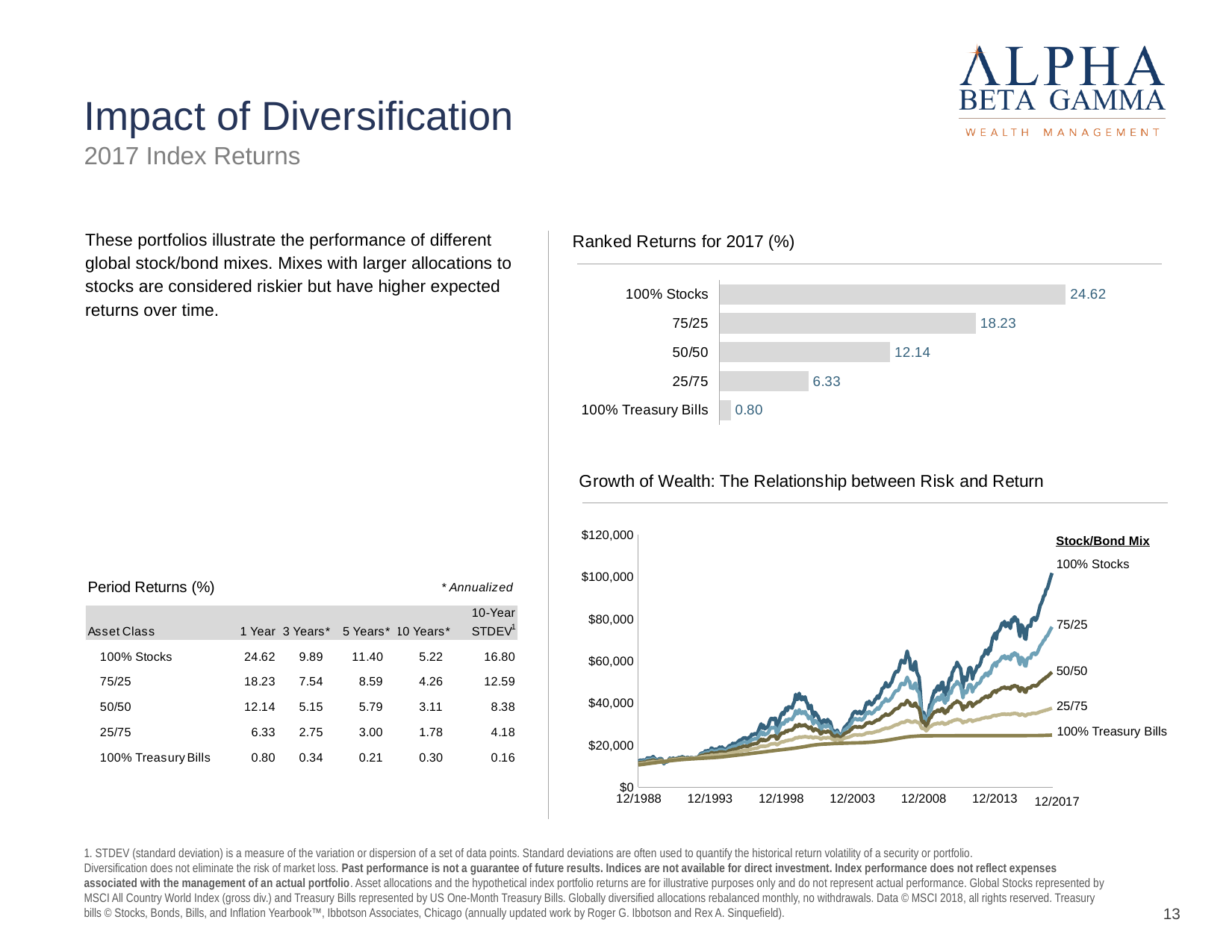
What kind of chart is the Growth of Wealth: The Relationship between Risk and Return chart? Line chart In the Ranked Returns for 2017 (%) chart, what is the value for 100% Treasury Bills? 0.80 In the Ranked Returns for 2017 (%) chart, which category has the lowest value? 100% Treasury Bills In the Growth of Wealth chart, is the value for 100% Stocks at 12/2017 greater or less than $80,000? greater What kind of chart is the Ranked Returns for 2017 (%) chart? Bar chart In the Ranked Returns for 2017 (%) chart, what is the value for 75/25? 18.23 In the Ranked Returns for 2017 (%) chart, which is larger, the value for 25/75 or the value for 50/50? 50/50 How many series are shown in the Growth of Wealth: The Relationship between Risk and Return chart? 5 In the Ranked Returns for 2017 (%) chart, what is the difference between the values for 100% Stocks and 50/50? 12.48 In the Ranked Returns for 2017 (%) chart, which category has the highest value? 100% Stocks In the Growth of Wealth chart, is the value for 100% Treasury Bills at 12/2017 greater or less than $40,000? less How many categories are shown in the Ranked Returns for 2017 (%) chart? 5